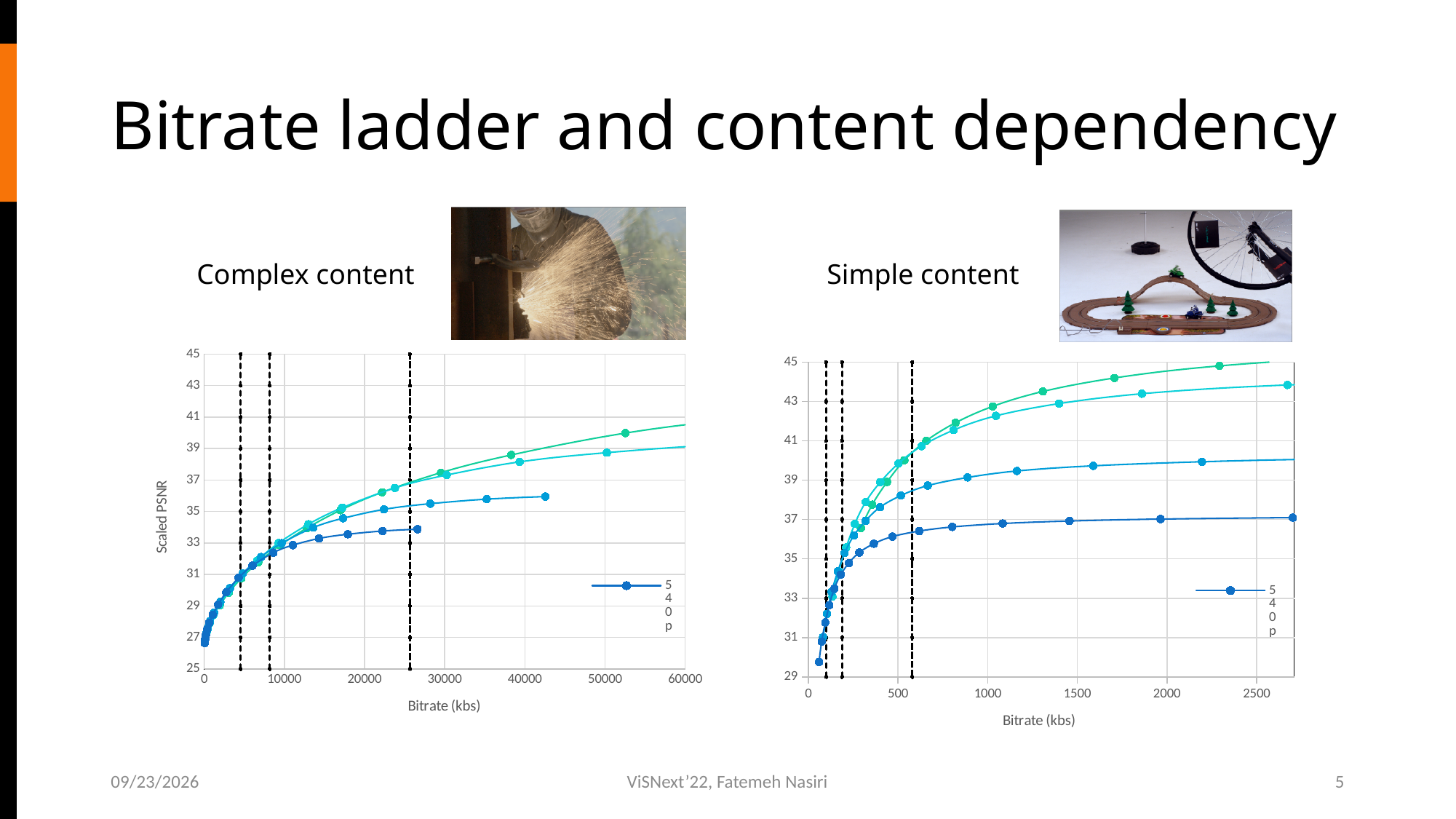
In the Complex content chart, do the Scaled PSNR values rise or fall as bitrate increases? rise In the Complex content chart, is the highest Scaled PSNR reached by the green curve greater or less than 39? greater In the Complex content chart, which curve reaches the highest Scaled PSNR, the green curve or the dark blue curve? green curve What is the label of the x axis on the Simple content chart? Bitrate (kbs) In the Complex content chart, is the last point of the dark blue curve (near 26000 kbs) greater or less than 33 Scaled PSNR? greater What is the maximum value shown on the x axis of the Complex content chart? 60000 In the Simple content chart, is the Scaled PSNR of the dark blue curve at about 2500 kbs greater or less than 35? greater What is the label of the y axis on the Complex content chart? Scaled PSNR What kind of chart is the Complex content chart on the left? line chart How many curves are plotted in the Simple content chart? 4 In the Simple content chart, do the Scaled PSNR values rise or fall as bitrate increases? rise